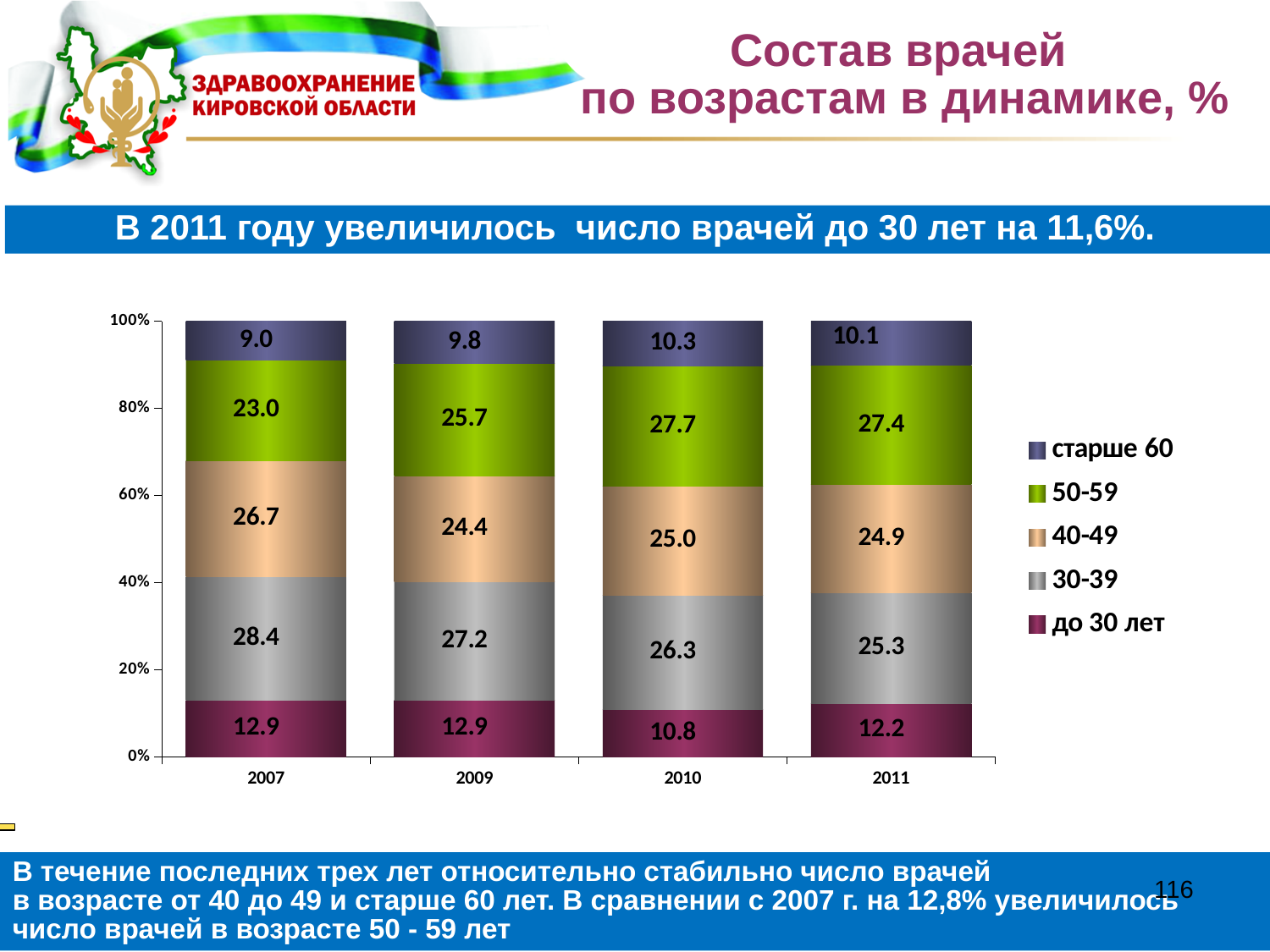
What is the value for the 50-59 series in 2011? 27.4 Does the 50-59 series rise or fall from 2007 to 2010? rise What is the difference between the 30-39 values in 2007 and 2011? 3.1 What is the value for the 30-39 series in 2009? 27.2 How many years are shown on the x axis? 4 Which is larger: the 40-49 value in 2007 or the 40-49 value in 2011? 2007 What kind of chart is shown on the slide? stacked bar chart How many series does the legend list? 5 In which year is the 50-59 series highest? 2010 What is the value for the старше 60 series in 2007? 9.0 In which year is the до 30 лет series lowest? 2010 What is the value for the до 30 лет series in 2010? 10.8